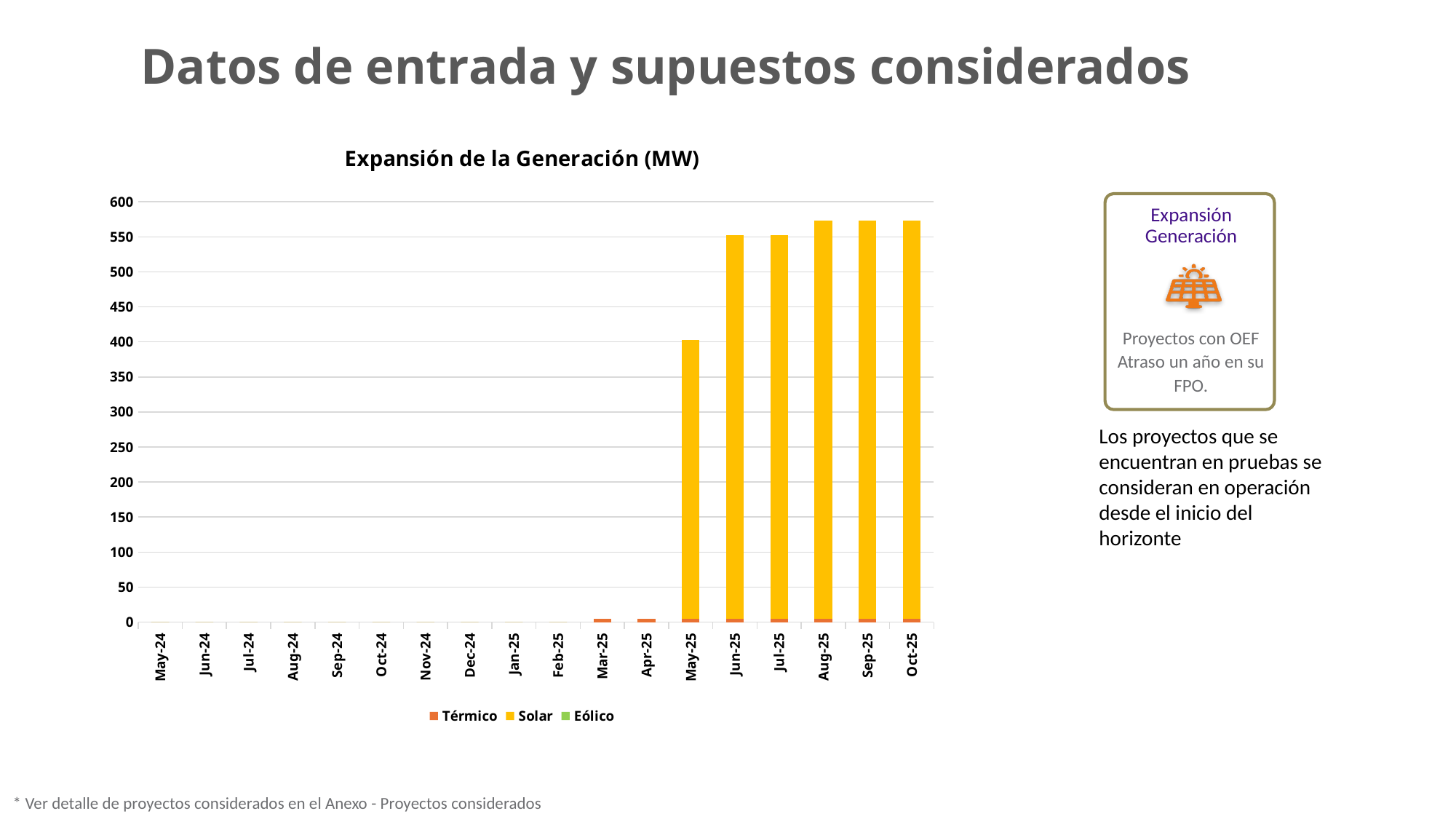
What kind of chart is shown on the slide? bar chart What is the title of the chart? Expansión de la Generación (MW) How many series does the chart legend list? 3 Which series are listed in the chart legend? Térmico, Solar, Eólico Is the total value for Oct-25 greater or less than 600? less Is the total value for May-25 greater or less than 450? less Is the total value for Jun-25 greater or less than 500? greater How many months are shown on the x axis of the chart? 18 Do the total values generally rise or fall from May-24 to Oct-25? rise Which is larger, the total value for May-25 or the total value for Jun-25? Jun-25